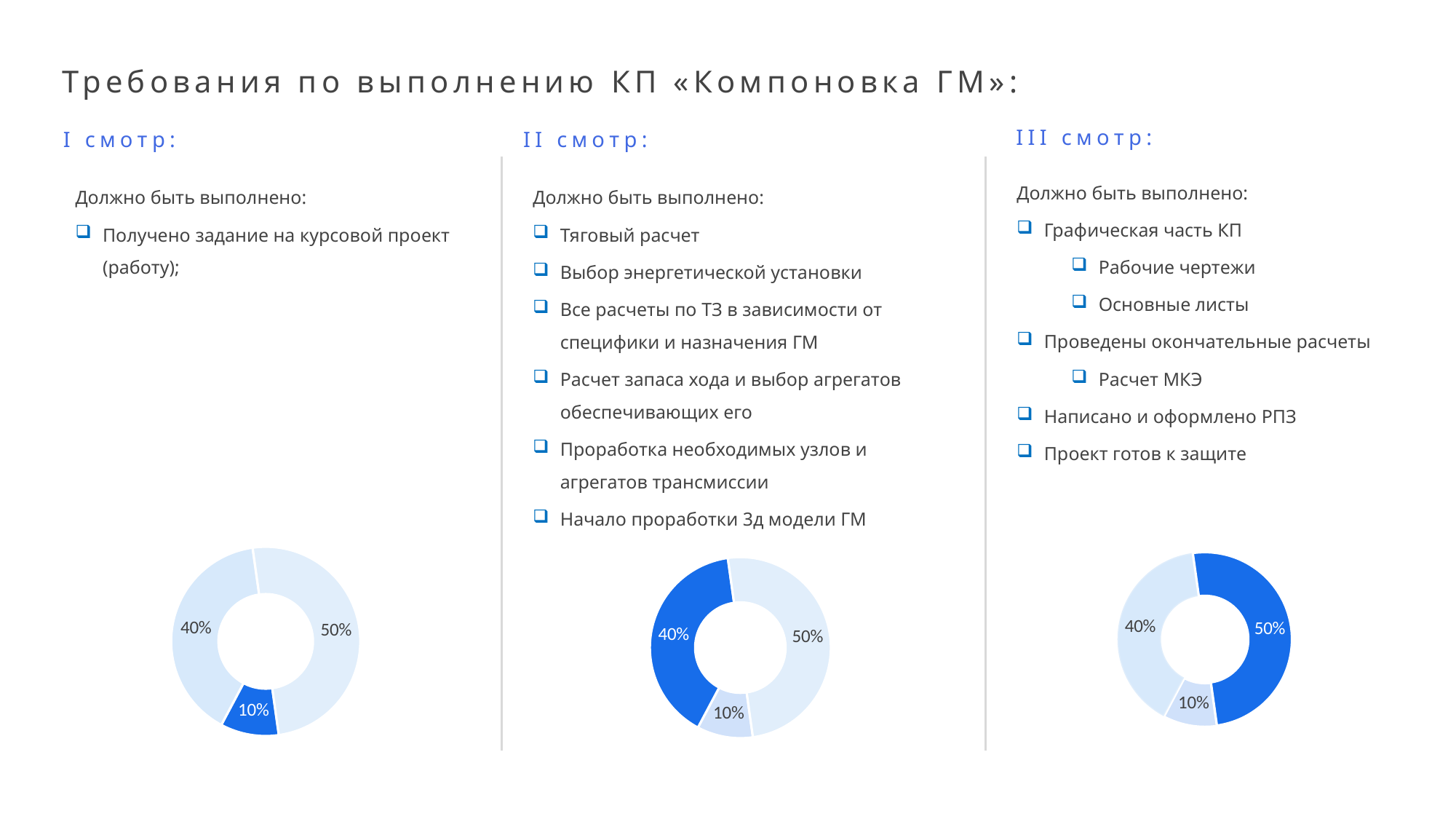
What is the total of the three slice values in the right doughnut chart (under "III смотр")? 100% In the left doughnut chart (under "I смотр"), what is the value of the largest slice? 50% In the right doughnut chart (under "III смотр"), which slice value is highlighted in dark blue? 50% How many doughnut charts are shown on the slide? 3 In the middle doughnut chart (under "II смотр"), what is the value of the largest slice? 50% In the middle doughnut chart (under "II смотр"), what is the difference between the largest and smallest slice values? 40% What kind of chart is shown under "I смотр" at the bottom left of the slide? Doughnut (pie) chart How many slices does the doughnut chart under "II смотр" (middle) have? 3 In the middle doughnut chart (under "II смотр"), which is larger: the dark blue slice or the 10% slice? The dark blue slice (40%) In the left doughnut chart (under "I смотр"), what is the value of the smallest slice? 10% In the left doughnut chart (under "I смотр"), which slice value is highlighted in dark blue? 10% In the right doughnut chart (under "III смотр"), what is the value of the smallest slice? 10%